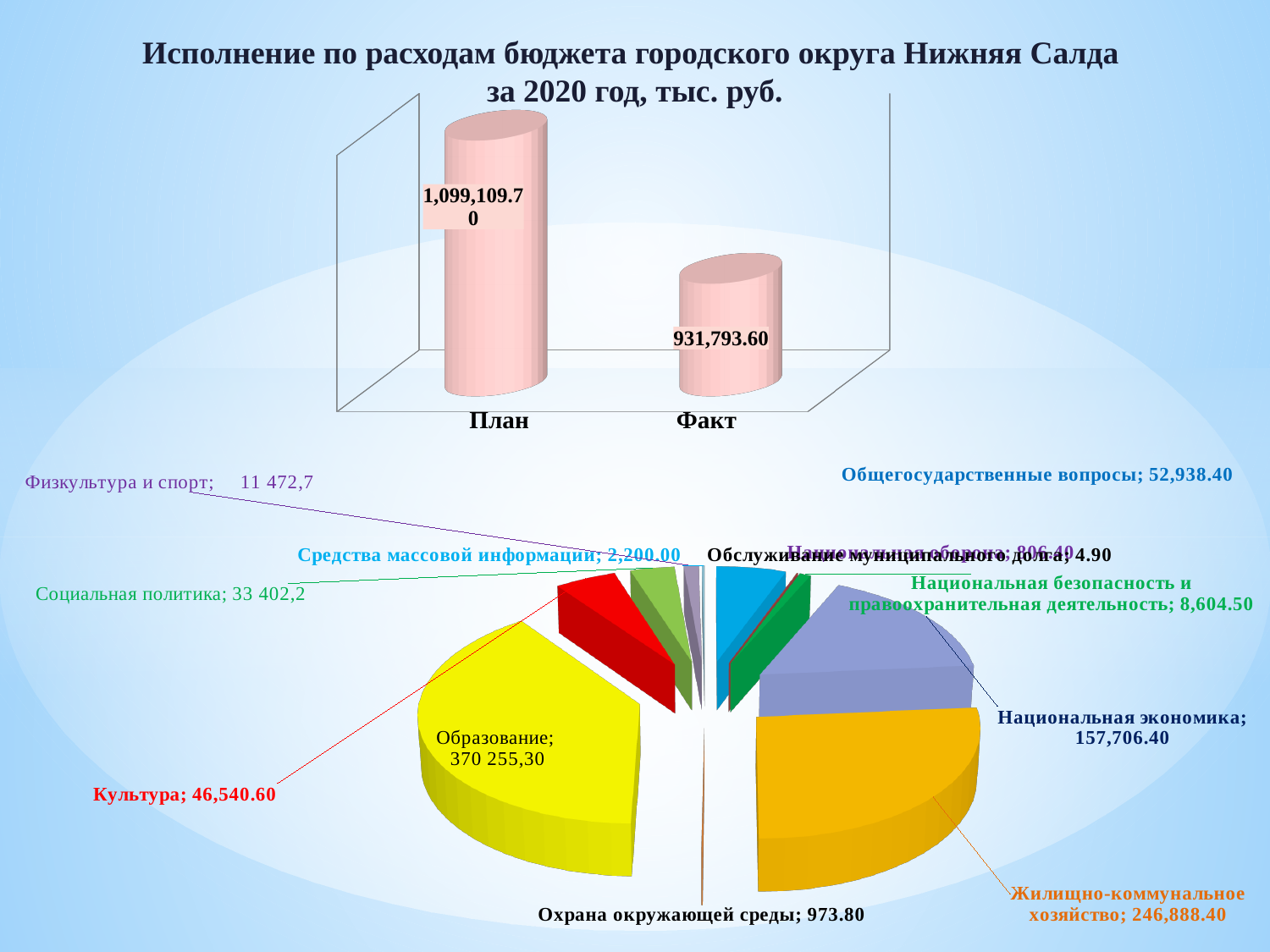
In the bar chart at the top, what is the value for Факт? 931,793.60 What kind of chart is the chart at the bottom of the slide? Pie chart In the pie chart, what is the value for Жилищно-коммунальное хозяйство? 246,888.40 In the bar chart at the top, which is larger, План or Факт? План In the pie chart, what is the difference between Национальная экономика and Общегосударственные вопросы? 104,768.00 In the pie chart, which is larger, Национальная экономика or Культура? Национальная экономика How many bars does the bar chart at the top show? 2 In the bar chart at the top, what is the value for План? 1,099,109.70 In the pie chart, what is the value for Образование? 370 255,30 In the bar chart at the top, what is the difference between План and Факт? 167,316.10 In the pie chart, which category has the largest slice? Образование What kind of chart is the chart at the top of the slide? Bar chart